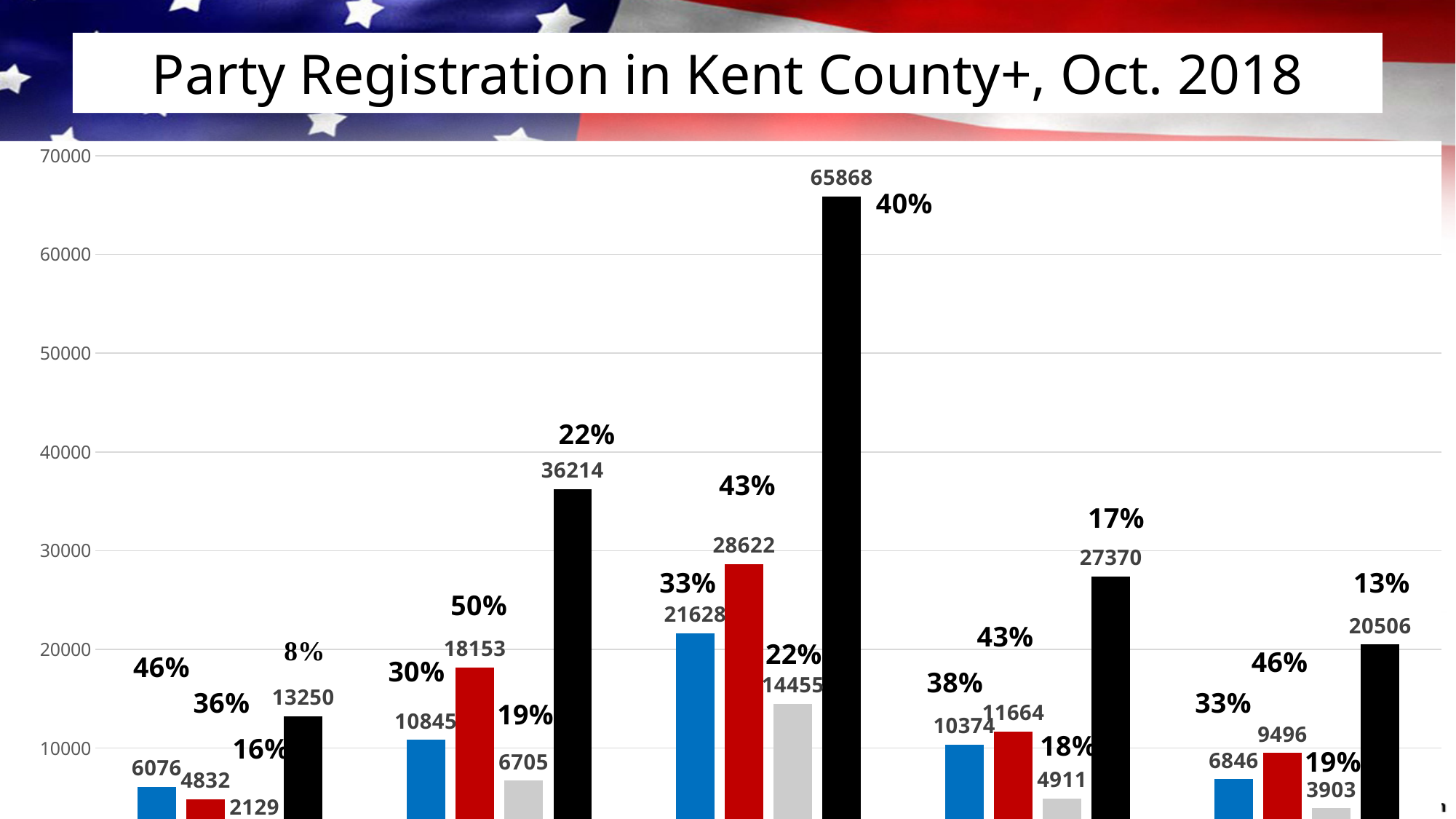
How many groups of bars are shown on the chart? 5 What is the value of the tallest bar on the chart? 65868 How many bars are in each group? 4 What is the value of the smallest bar in the first group of bars from the left? 2129 What percentage label is shown for the gray bar in the first group of bars from the left? 16% What is the value of the blue bar in the third group of bars from the left? 21628 What is the title of the chart? Party Registration in Kent County+, Oct. 2018 What is the value of the red bar in the second group of bars from the left? 18153 What is the difference between the black bar in the third group (65868) and the black bar in the second group (36214)? 29654 Is the value of the black bar in the fourth group of bars greater or less than 30000? less What kind of chart is shown on the slide? bar chart In the fourth group of bars from the left, which is larger: the red bar or the blue bar? the red bar